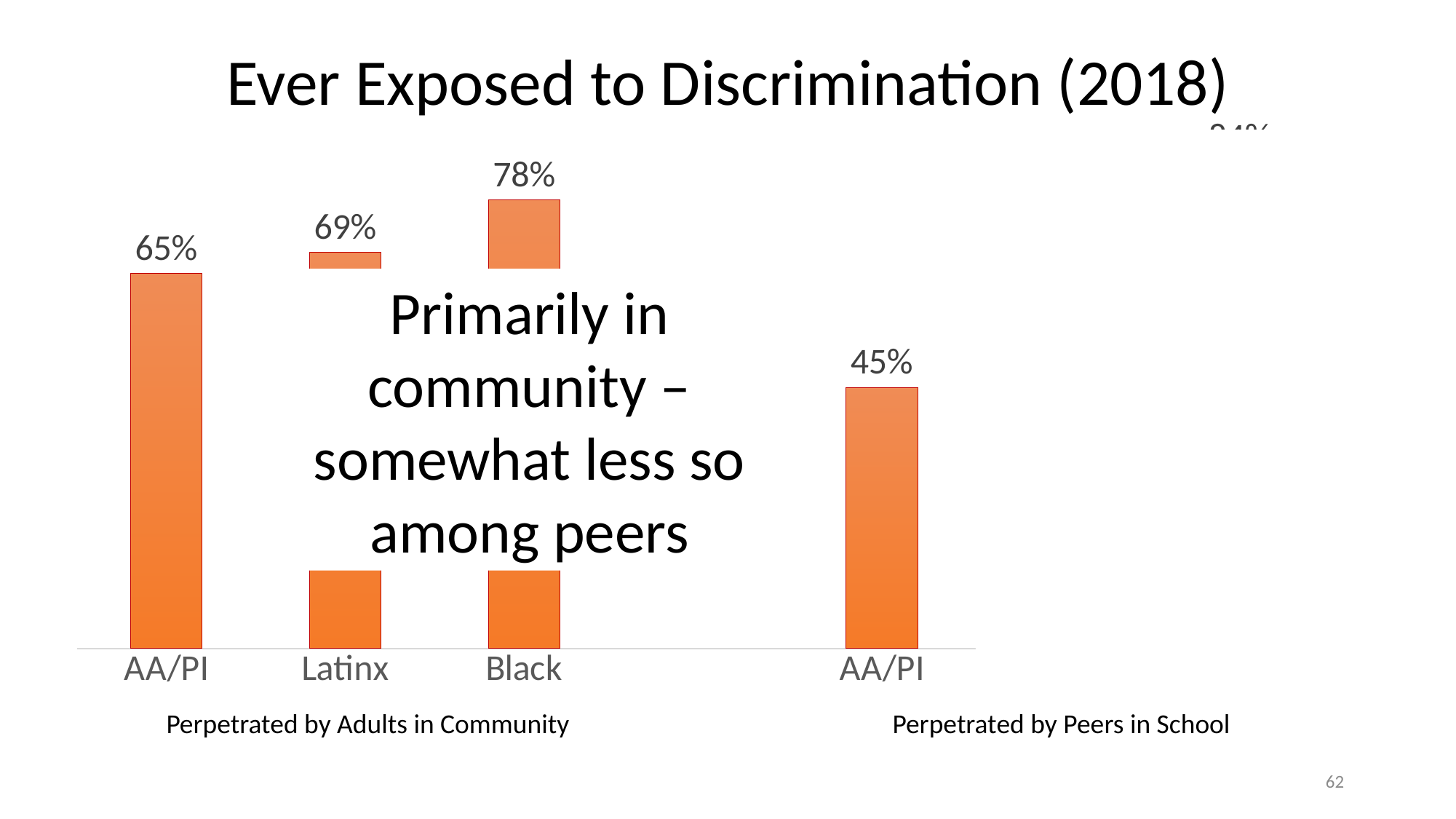
What percentage of AA/PI respondents reported discrimination perpetrated by adults in the community? 65% What percentage of AA/PI respondents reported discrimination perpetrated by peers in school? 45% How many percentage points higher is the Black value than the AA/PI value under 'Perpetrated by Adults in Community'? 13 percentage points What type of chart is shown on the slide? Bar chart Is the AA/PI value for 'Perpetrated by Peers in School' greater or less than the AA/PI value for 'Perpetrated by Adults in Community'? less What is the value shown for Black under 'Perpetrated by Adults in Community'? 78% What is the value shown for Latinx under 'Perpetrated by Adults in Community'? 69% What is the title of the chart? Ever Exposed to Discrimination (2018) Under 'Perpetrated by Adults in Community', which is larger: the Latinx value or the AA/PI value? Latinx Among the 'Perpetrated by Adults in Community' bars, which group has the highest value? Black Among the 'Perpetrated by Adults in Community' bars, which group has the lowest value? AA/PI What is the difference between the AA/PI value for adults in the community and the AA/PI value for peers in school? 20 percentage points